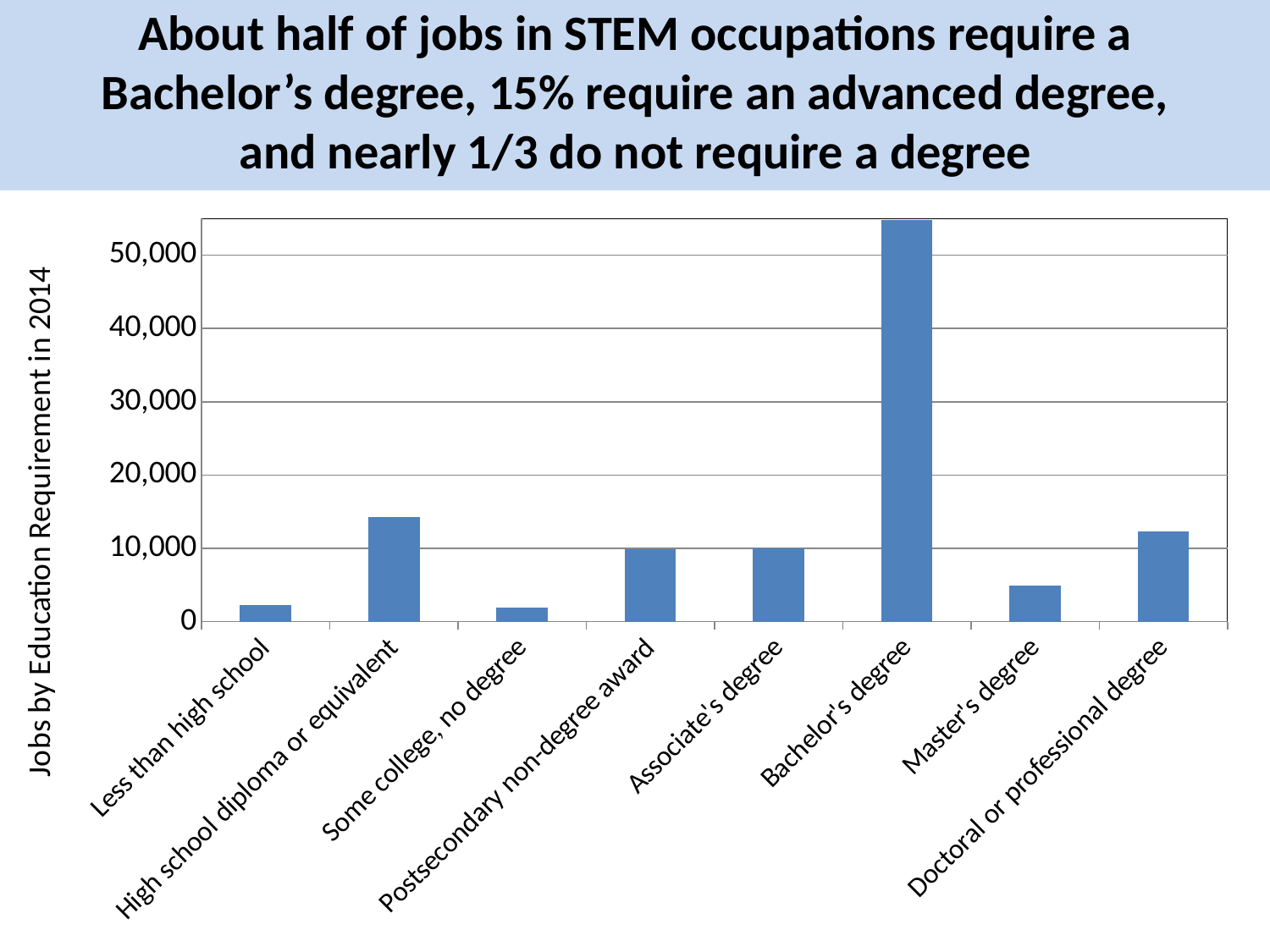
Is the value for High school diploma or equivalent greater or less than 10,000? greater Is the value for Doctoral or professional degree greater or less than 10,000? greater Which is larger: the value for High school diploma or equivalent or the value for Doctoral or professional degree? High school diploma or equivalent Is the value for Master's degree greater or less than 10,000? less What kind of chart is shown on the slide? bar chart Which is larger: the value for Bachelor's degree or the value for Master's degree? Bachelor's degree Which education category has the highest number of jobs in the chart? Bachelor's degree What is the label on the vertical axis of the chart? Jobs by Education Requirement in 2014 How many education categories are shown on the x axis of the chart? 8